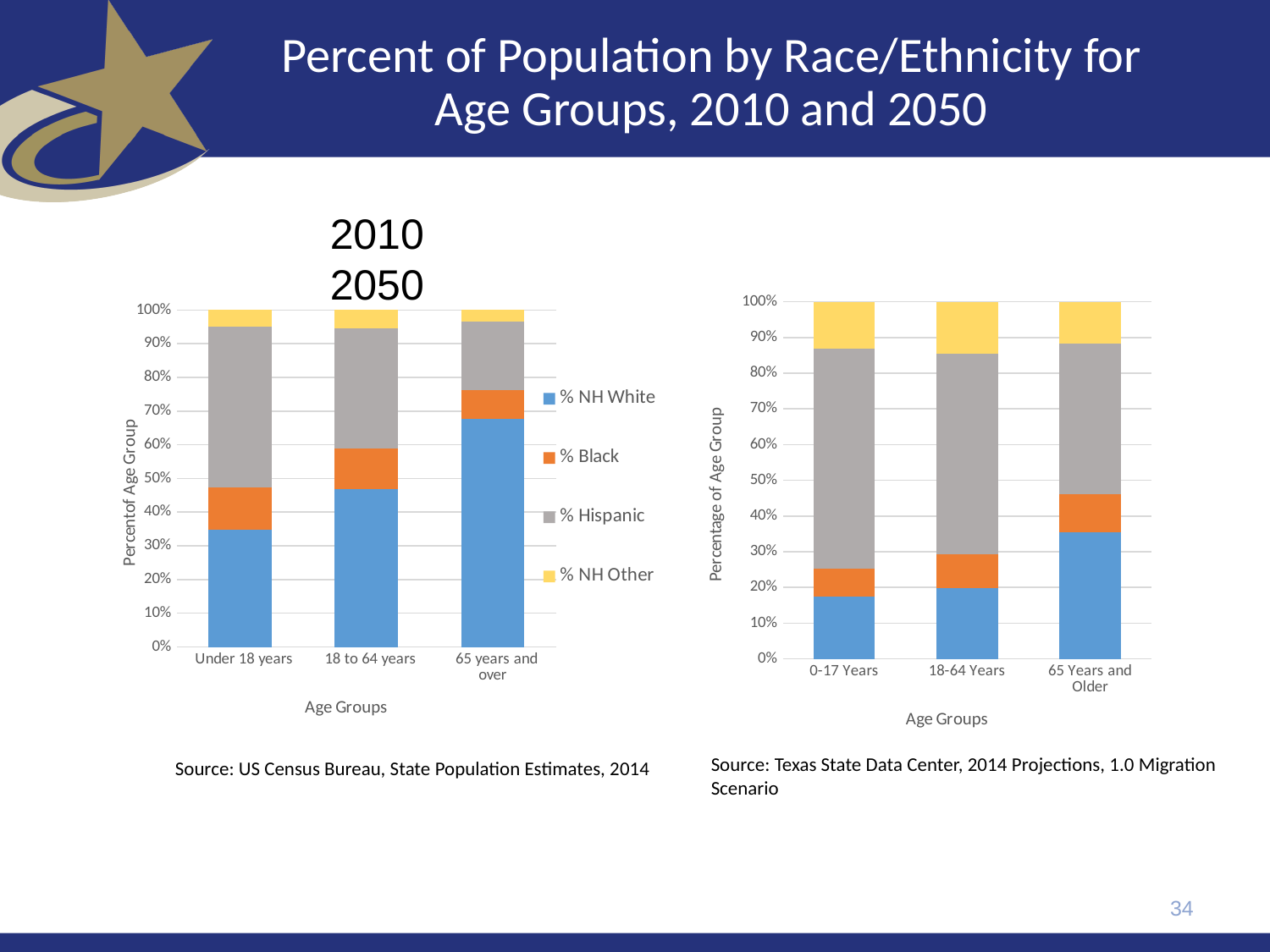
On the left chart, is the % Hispanic segment larger for Under 18 years or for 65 years and over? Under 18 years On the right chart, is the % NH White value for 65 Years and Older greater or less than 30%? greater How many series does the legend on the left chart list? 4 What kind of chart is the left chart on the slide? Stacked bar chart On the left chart, which age group has the largest % NH White segment? 65 years and over On the right chart, is the % NH White value for 0-17 Years greater or less than 20%? less On the left chart, is the % NH White value for 65 years and over greater or less than 60%? greater On the right chart, which age group has the largest % NH White segment? 65 Years and Older What is the y-axis label of the right chart? Percentage of Age Group How many age groups are shown on the right chart? 3 How many age groups are shown on the left chart? 3